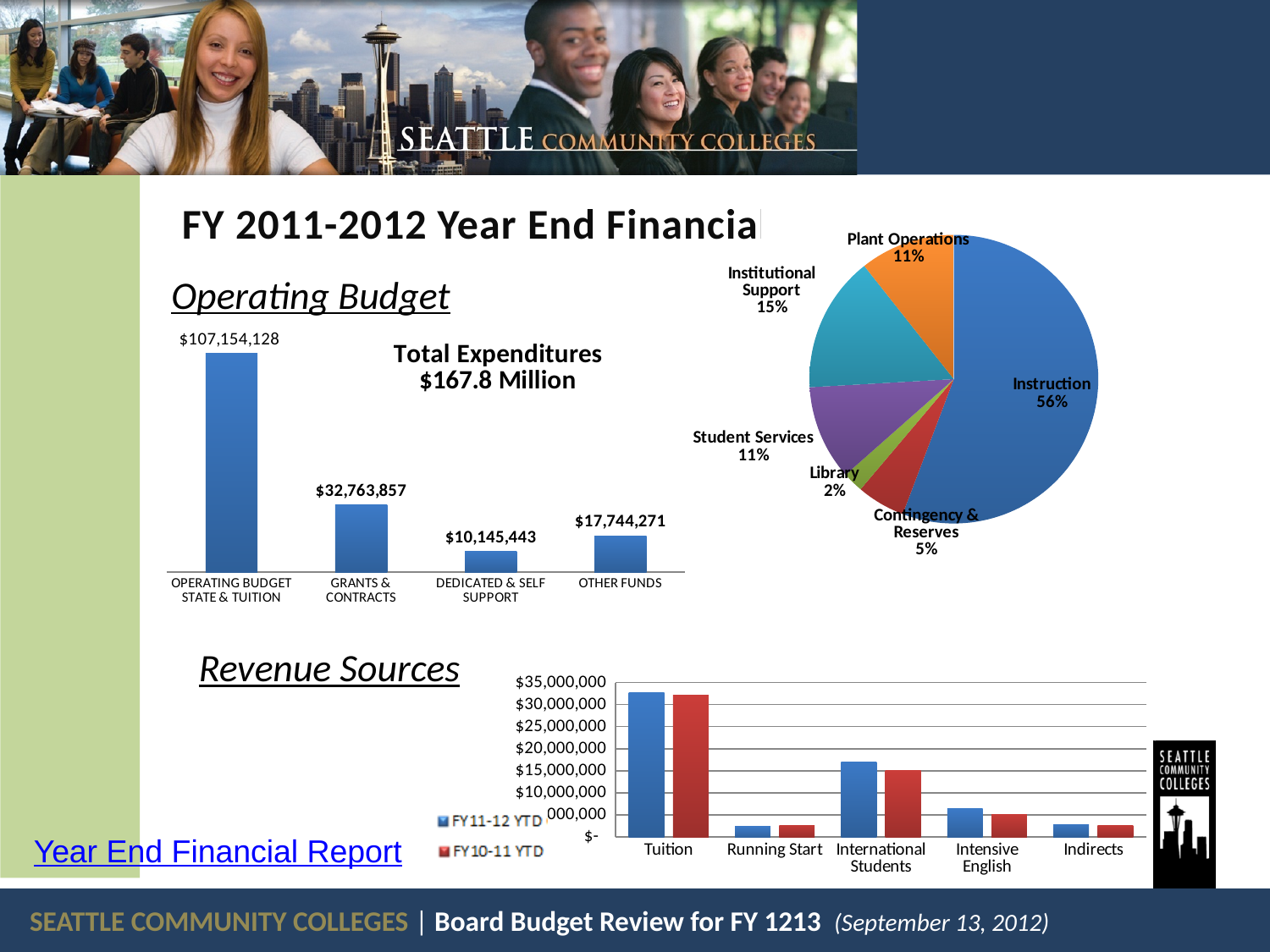
In the Operating Budget bar chart, what is the value for Grants & Contracts? $32,763,857 In the Operating Budget bar chart, what is the difference between Operating Budget State & Tuition and Grants & Contracts? $74,390,271 In the Revenue Sources chart, is the FY11-12 YTD value for Intensive English greater or less than $10,000,000? less In the Revenue Sources chart, how many series does the legend list? 2 In the Operating Budget bar chart, what is the value for Operating Budget State & Tuition? $107,154,128 In the pie chart, what share does Instruction have? 56% In the Revenue Sources chart, is the FY11-12 YTD value for Tuition greater or less than $30,000,000? greater In the pie chart, which category has the smallest slice? Library In the Operating Budget bar chart, which category has the lowest value? Dedicated & Self Support In the pie chart, what share does Institutional Support have? 15% In the pie chart, how many slices are there? 6 In the Operating Budget bar chart, how many categories are shown? 4